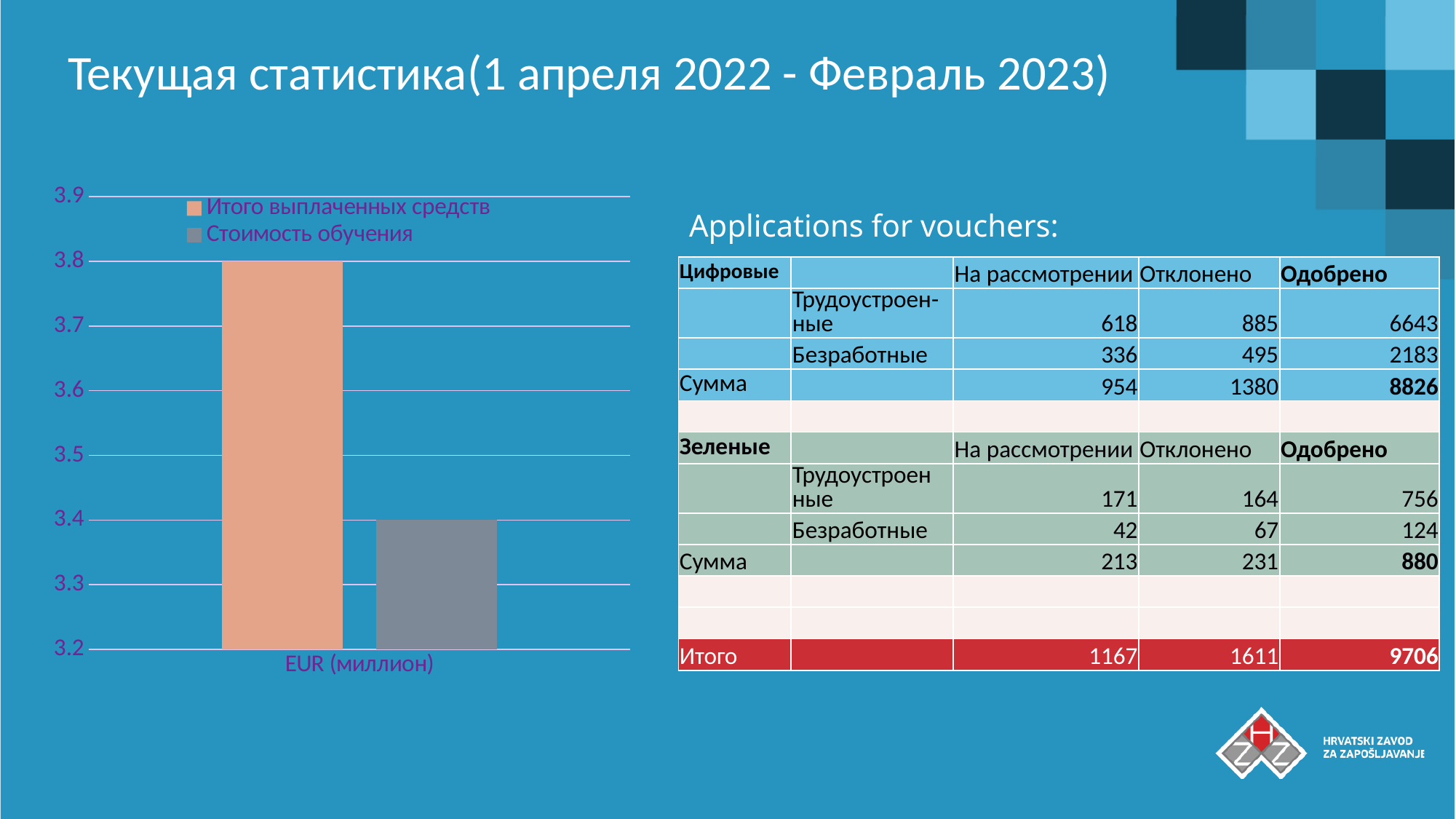
What is the highest value shown on the chart's y axis? 3.9 Which series has the higher bar in the chart? Итого выплаченных средств Is the bar for Итого выплаченных средств greater or less than 3.7? greater Which is larger in the chart: Итого выплаченных средств or Стоимость обучения? Итого выплаченных средств Is the bar for Стоимость обучения greater or less than 3.5? less Is the bar for Стоимость обучения greater or less than 3.3? greater What is the label on the x axis of the chart? EUR (миллион) Which series has the lower bar in the chart? Стоимость обучения What colour is the bar for Стоимость обучения in the chart? grey How many series does the chart legend list? 2 What kind of chart is shown on the left of the slide? bar chart How many categories are shown on the x axis of the chart? 1